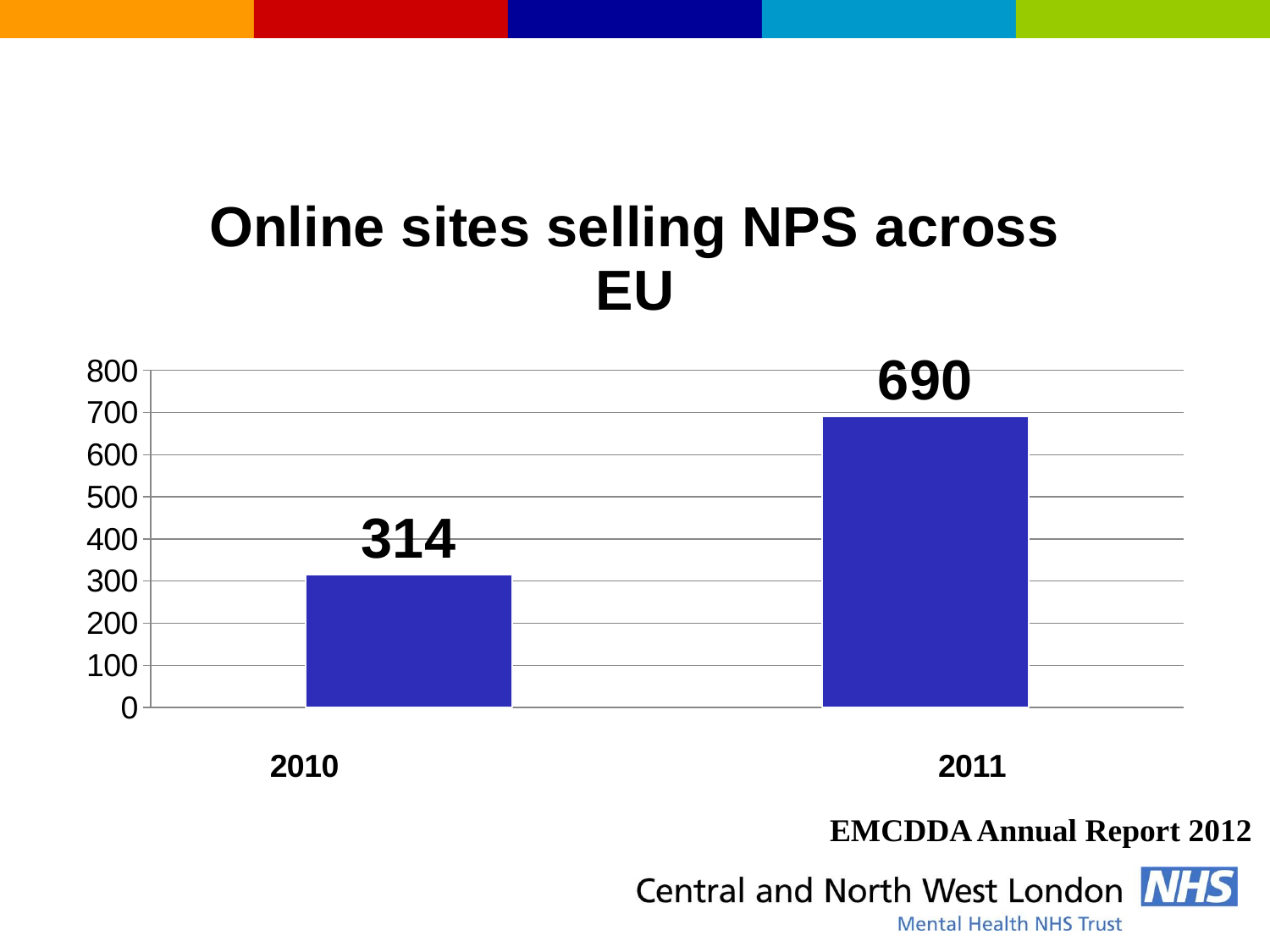
How many years are shown on the chart? 2 What is the value for 2011? 690 Which year has the lowest value? 2010 What is the value for 2010? 314 Is the value for 2011 greater or less than 600? greater What is the title of the chart? Online sites selling NPS across EU What kind of chart is shown on the slide? bar chart What is the difference between the values for 2011 and 2010? 376 Is the value for 2010 greater or less than 400? less Which is larger, the value for 2010 or the value for 2011? 2011 Do the values rise or fall from 2010 to 2011? rise Which year has the highest value? 2011